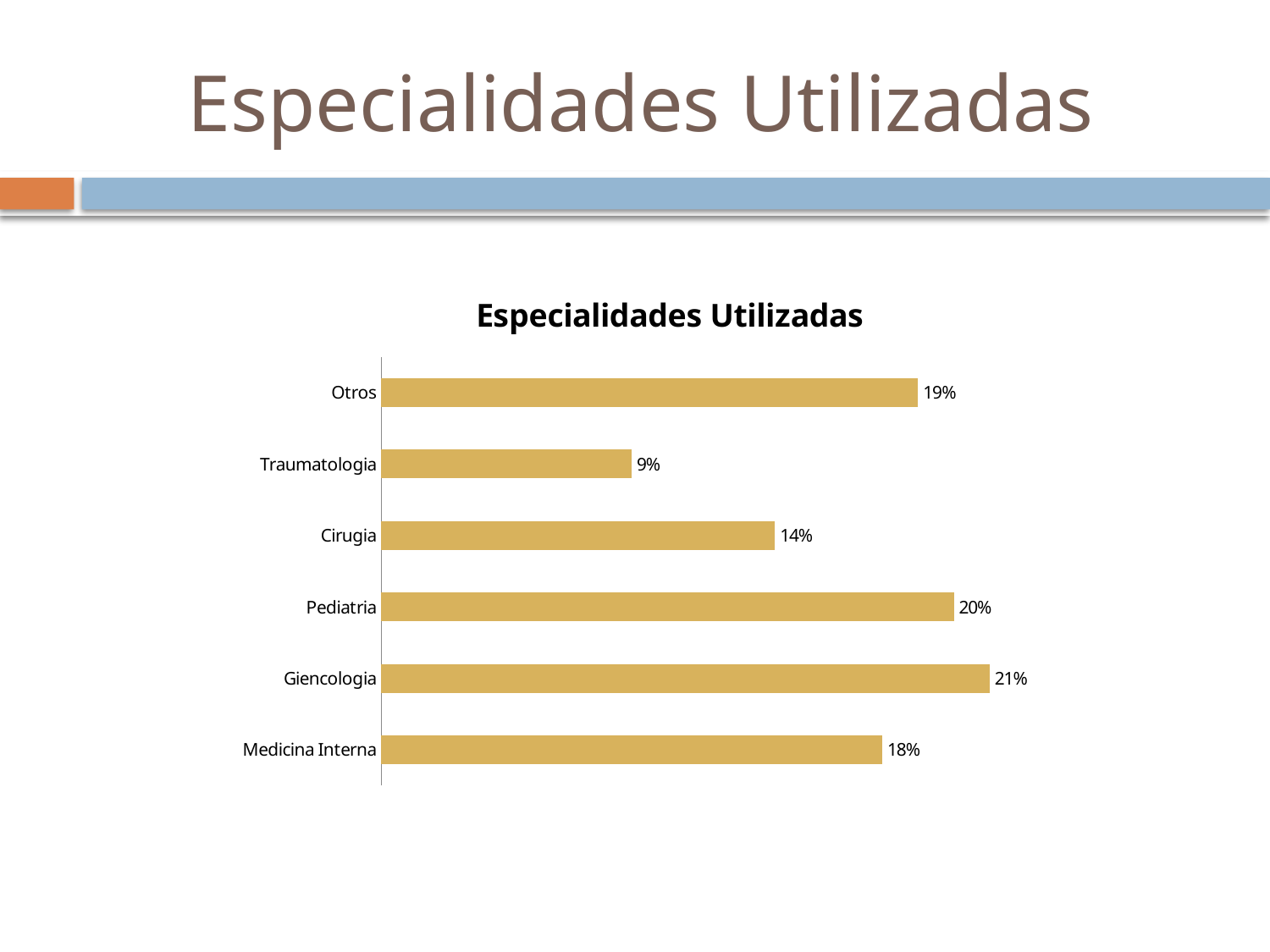
How many categories are shown in the chart? 6 What kind of chart is shown on the slide? Bar chart What is the value for Medicina Interna? 18% What is the value for Cirugia? 14% What is the difference between the values for Otros and Cirugia? 5% Which category has the highest value? Giencologia What is the value for Traumatologia? 9% Which category has the lowest value? Traumatologia What is the value for Pediatria? 20% What is the difference between the values for Giencologia and Traumatologia? 12% Which is larger, the value for Pediatria or the value for Medicina Interna? Pediatria What is the title of the chart? Especialidades Utilizadas